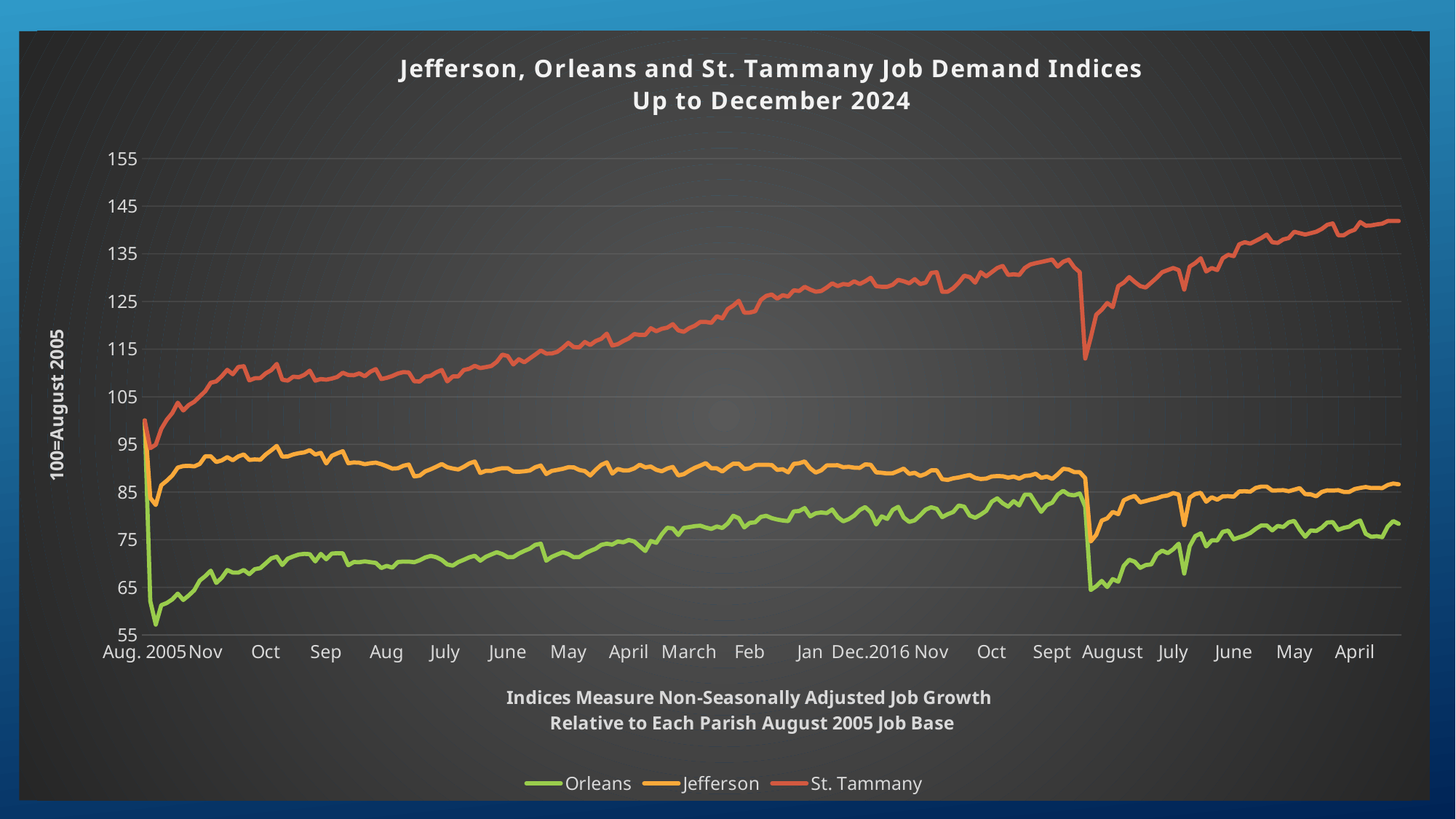
What is the title of the chart? Jefferson, Orleans and St. Tammany Job Demand Indices Up to December 2024 Is the value for Orleans at the right end of the chart greater or less than 85? less At the right end of the chart, which is larger: the St. Tammany value or the Jefferson value? St. Tammany Does the St. Tammany line generally rise or fall from left to right across the chart? rise What kind of chart is shown on the slide? line chart Which series has the highest values across the chart? St. Tammany Is the lowest value for Orleans, near Aug. 2005, greater or less than 65? less Which series are listed in the legend? Orleans, Jefferson, St. Tammany Is the value for St. Tammany at the right end of the chart greater or less than 135? greater How many series does the legend list? 3 Which series has the lowest values across the chart? Orleans